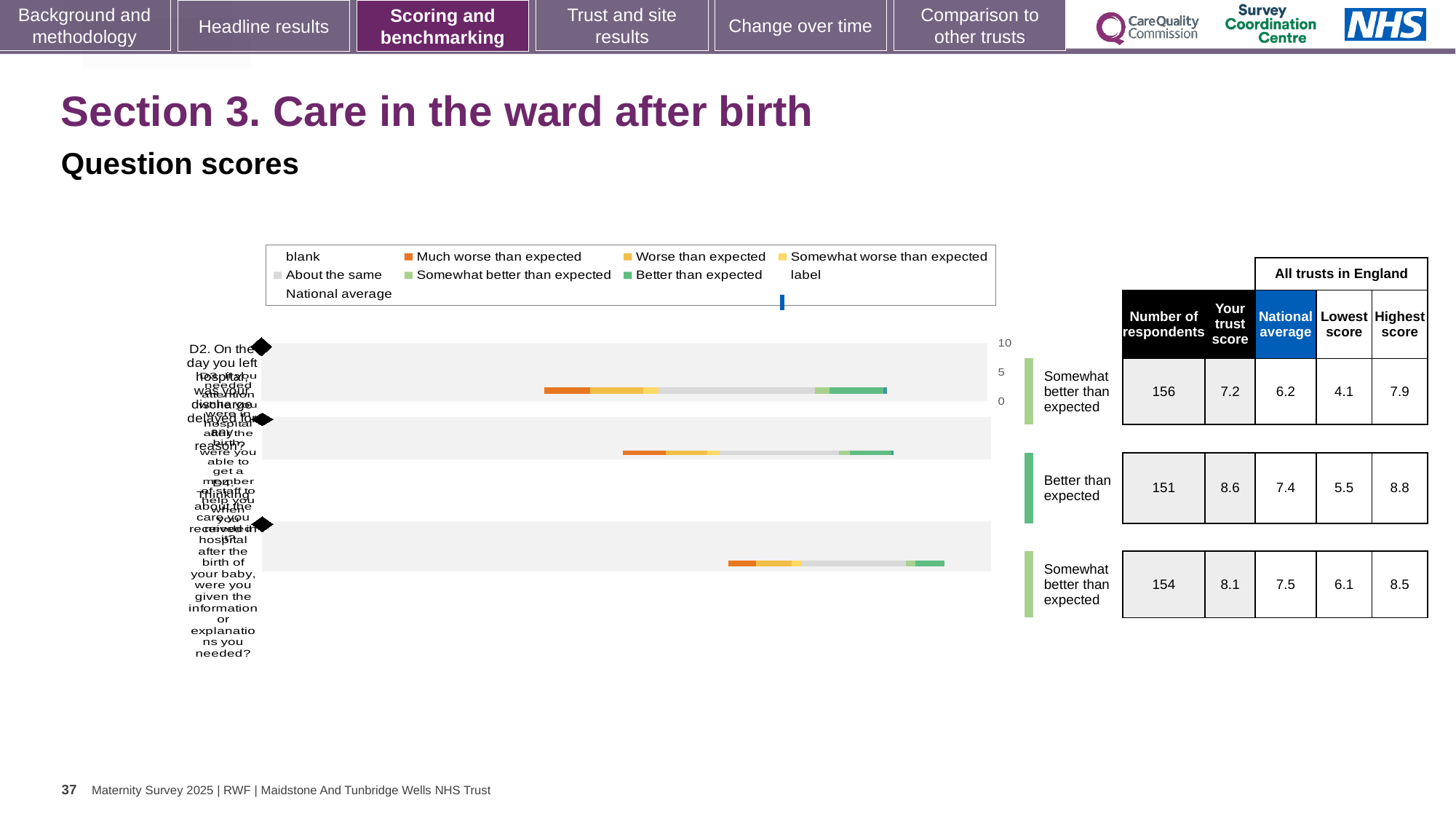
For the middle row of the chart, what is the difference between the trust score (8.6) and the national average (7.4)? 1.2 For the top row of the chart, what is the difference between the highest score (7.9) and the lowest score (4.1) across all trusts in England? 3.8 What is the highest score across all trusts in England for the bottom row of the chart? 8.5 Which row of the chart has the lowest number of respondents? the middle row (Better than expected), 151 What is the maximum value shown on the chart's score axis? 10 For the top row of the chart, which is larger: the trust score or the national average? the trust score (7.2) What kind of chart is shown on the slide? bar chart What does the blue vertical marker in the chart legend represent? National average How many question rows (bars) are plotted in the chart? 3 Which row of the chart has the highest 'Your trust score'? the middle row (Better than expected), 8.6 What is the number of respondents for the middle row of the chart (labelled 'Better than expected')? 151 What is the 'Your trust score' for the top row of the chart (labelled 'Somewhat better than expected')? 7.2